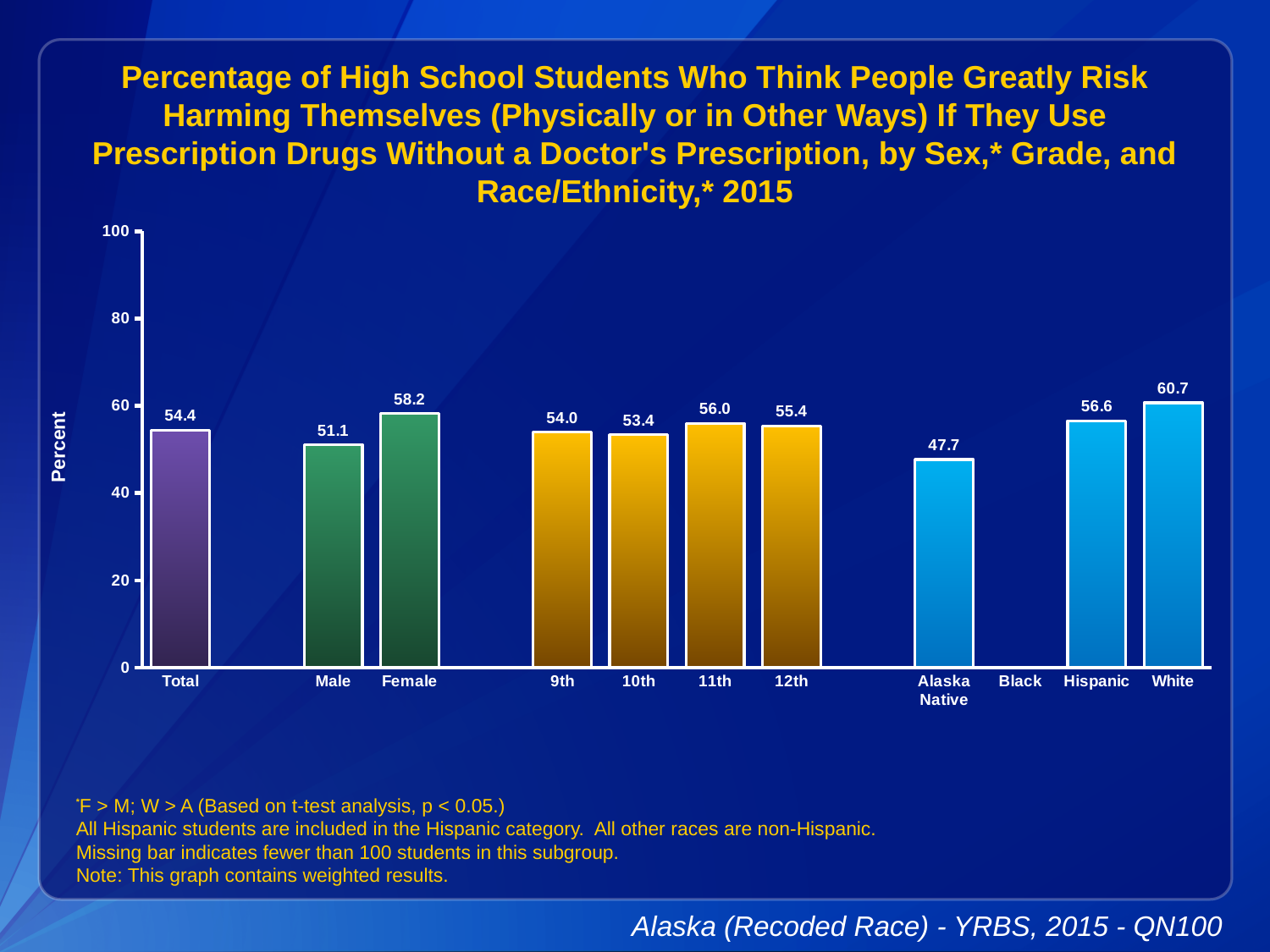
How many categories have a plotted bar? 10 What kind of chart is shown? bar chart Which category has the highest value? White Which category has no bar shown? Black What is the label on the y axis? Percent What is the value for Female? 58.2 What is the value for Alaska Native? 47.7 What is the difference between the Female and Male values? 7.1 Which is larger, the value for 9th grade or the value for 10th grade? 9th grade Which category with a plotted bar has the lowest value? Alaska Native Is the value for Hispanic greater or less than 40? greater What is the value for 11th grade? 56.0